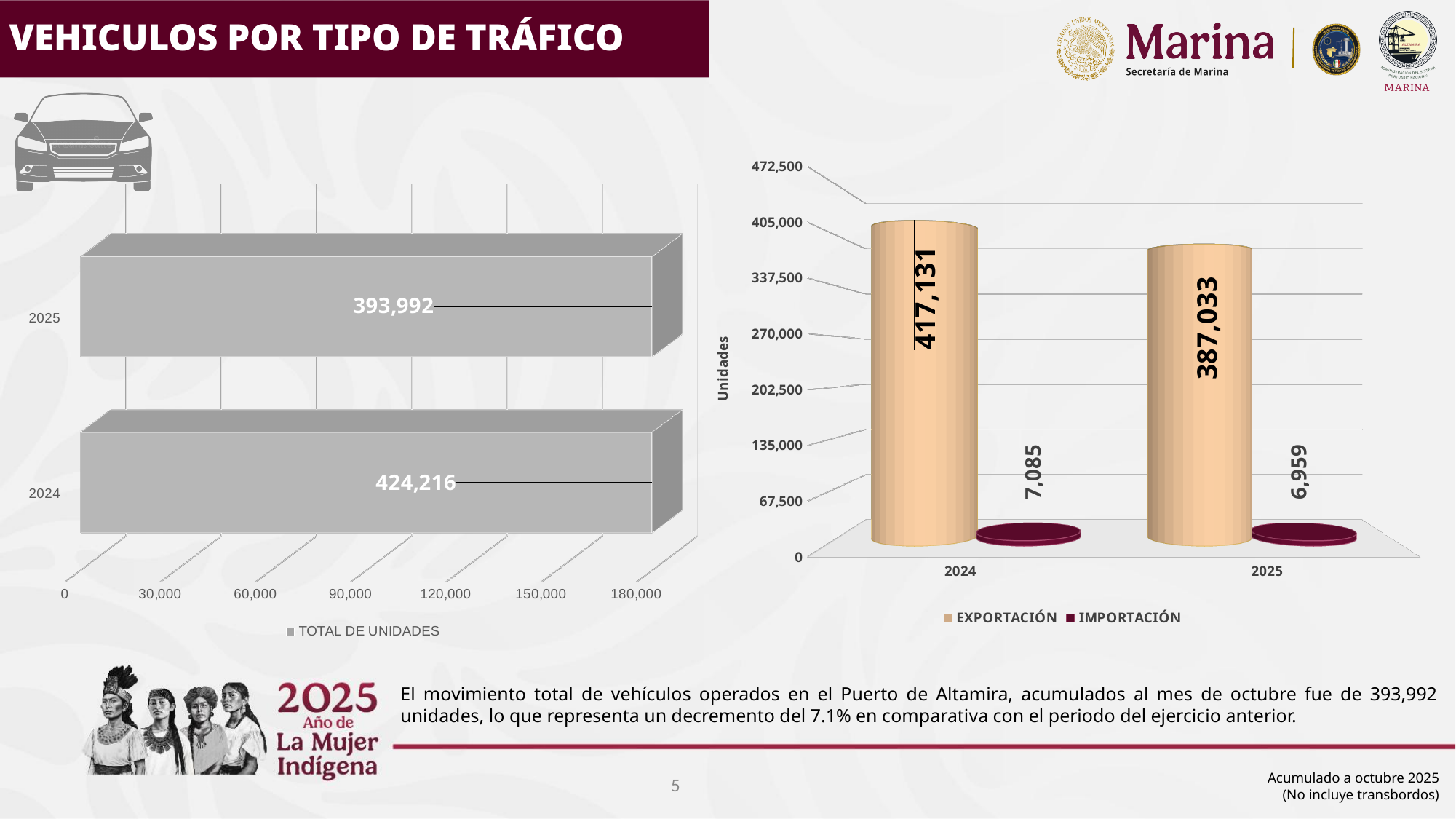
On the right chart, does EXPORTACIÓN rise or fall from 2024 to 2025? Fall On the right chart, what is the difference between EXPORTACIÓN in 2024 and EXPORTACIÓN in 2025? 30,098 What kind of chart is the left chart? Bar chart On the right chart, what is the EXPORTACIÓN value for 2024? 417,131 On the left chart, what is the value for 2025? 393,992 On the right chart, what is the IMPORTACIÓN value for 2025? 6,959 On the right chart, is the IMPORTACIÓN value for 2024 greater or less than 67,500? less On the left chart, what is the difference between the 2024 and 2025 values? 30,224 On the left chart, which year has the higher total of units? 2024 On the left chart, what series name does the legend show? TOTAL DE UNIDADES On the left chart, what is the value for 2024? 424,216 On the right chart, how many series does the legend list? 2